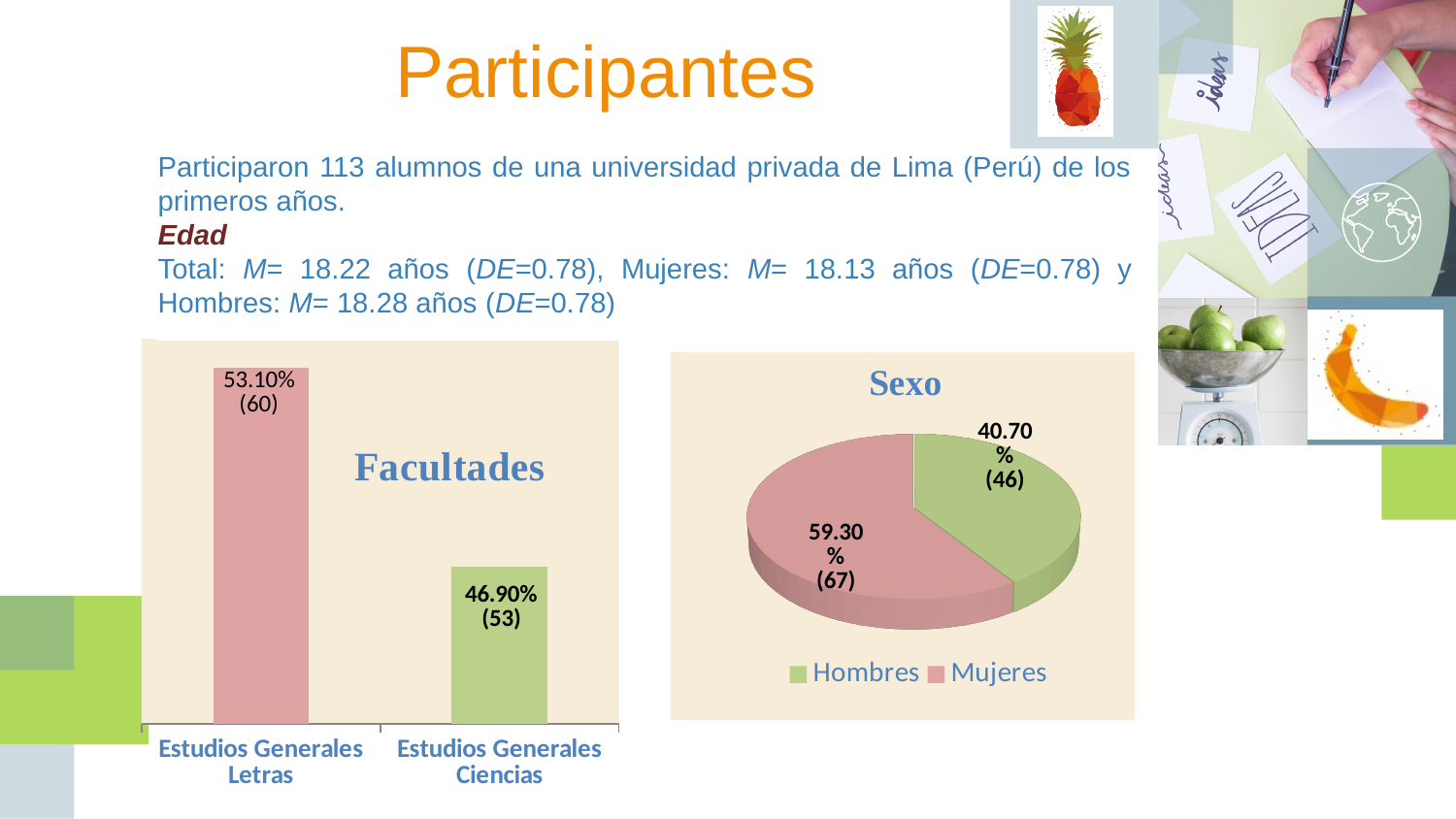
In the Facultades bar chart, what percentage is shown for Estudios Generales Letras? 53.10% What type of chart is the Facultades chart? Bar chart In the Facultades bar chart, what is the difference in percentage points between Estudios Generales Letras and Estudios Generales Ciencias? 6.20% In the Facultades bar chart, what percentage is shown for Estudios Generales Ciencias? 46.90% In the Facultades bar chart, how many categories are shown? 2 In the Facultades bar chart, which faculty has the higher value? Estudios Generales Letras In the Facultades bar chart, how many students are in Estudios Generales Letras according to the data label? 60 In the Sexo pie chart, what colour represents Hombres? Green In the Sexo pie chart, how many entries does the legend list? 2 In the Sexo pie chart, what percentage is shown for Mujeres? 59.30% In the Sexo pie chart, which group has the larger share? Mujeres In the Sexo pie chart, how many participants are Hombres according to the data label? 46